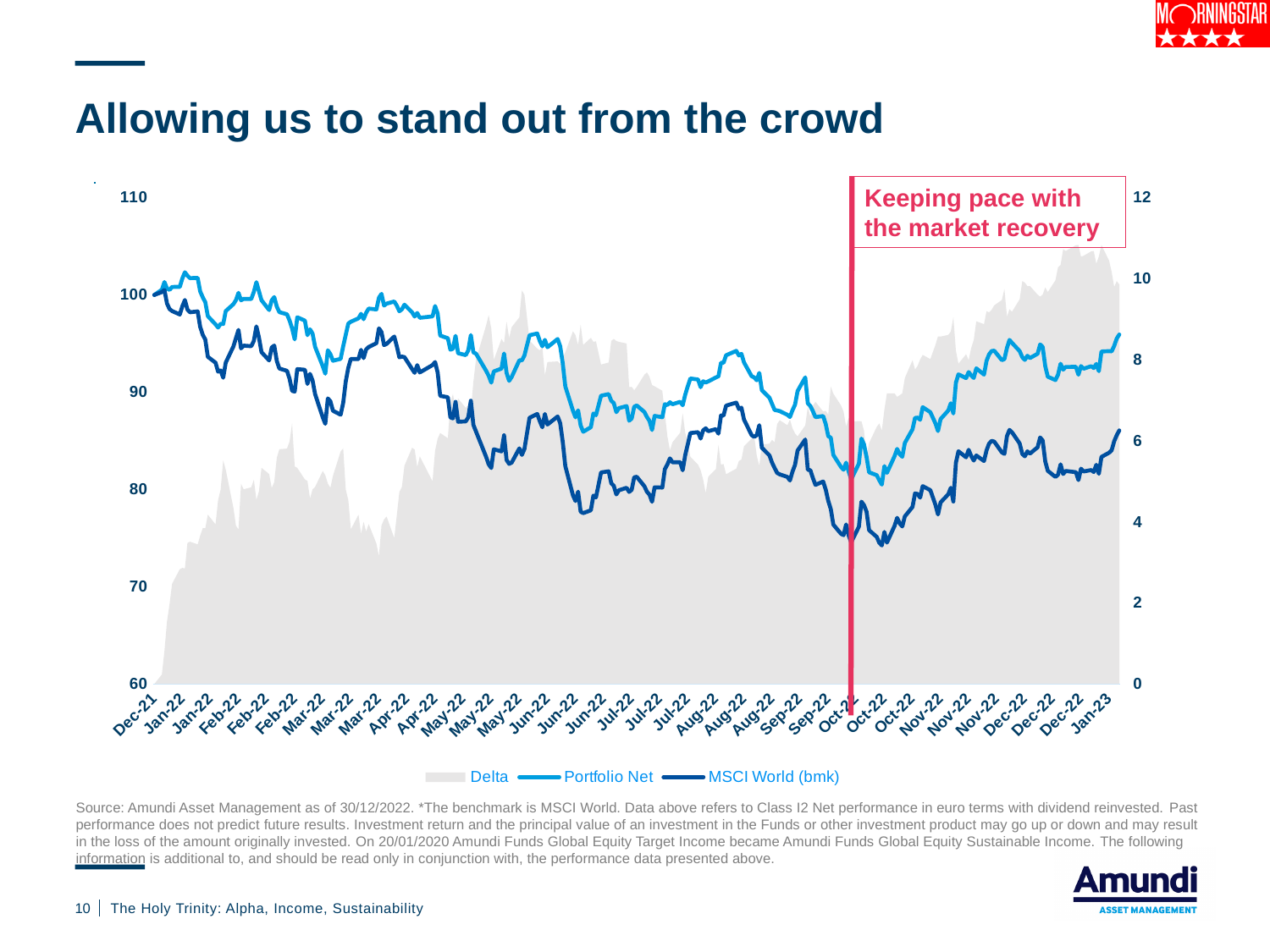
What is the highest value shown on the left vertical axis? 110 How many series does the legend list? 3 What text appears in the red-bordered annotation box on the chart? Keeping pace with the market recovery What kind of chart is shown on the slide? combination area and line chart At what value on the left axis do both the Portfolio Net and MSCI World (bmk) lines start in Dec-21? 100 Is the MSCI World (bmk) value at Jan-23 greater or less than 90? less What are the three entries in the chart legend? Delta, Portfolio Net, MSCI World (bmk) Which line is lower at Jun-22, Portfolio Net or MSCI World (bmk)? MSCI World (bmk) Which line is higher at Jan-23, Portfolio Net or MSCI World (bmk)? Portfolio Net Is the Portfolio Net value at Jan-23 greater or less than 90? greater Do the Portfolio Net and MSCI World (bmk) lines rise or fall between Oct-22 and Jan-23? rise Is the lowest point of the MSCI World (bmk) line, around Oct-22, greater or less than 80? less